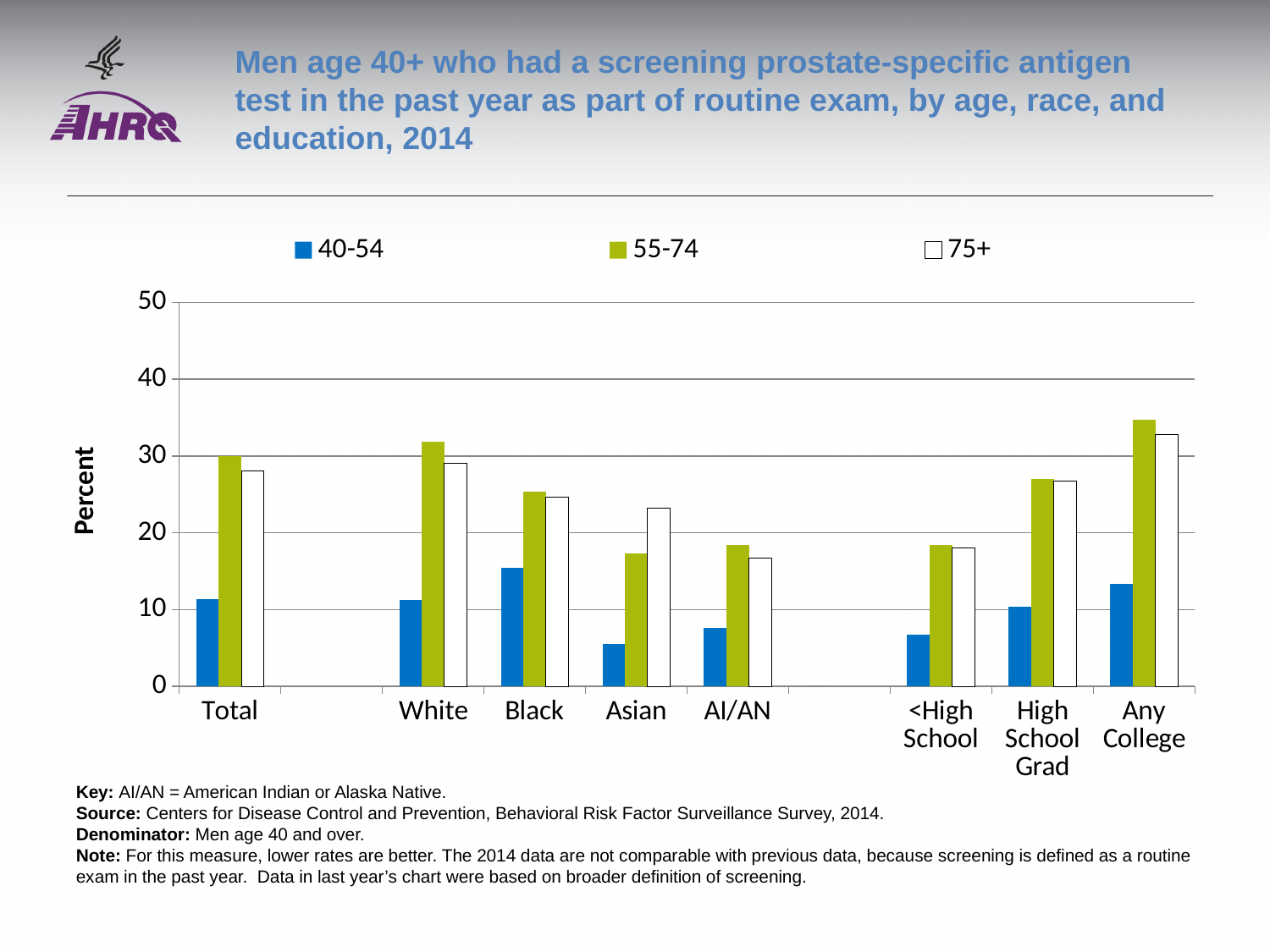
For the Asian category, which series has the larger value: 55-74 or 75+? 75+ Which category has the lowest value for the 40-54 series? Asian Is the value for Black in the 40-54 series greater or less than 10? greater Is the value for Total in the 55-74 series greater or less than 20? greater Is the value for Any College in the 55-74 series greater or less than 30? greater What is the label on the y axis? Percent Which category has the highest value for the 75+ series? Any College What kind of chart is shown on the slide? bar chart How many categories are shown along the x axis? 8 How many series does the legend list? 3 Which category has the highest value for the 55-74 series? Any College